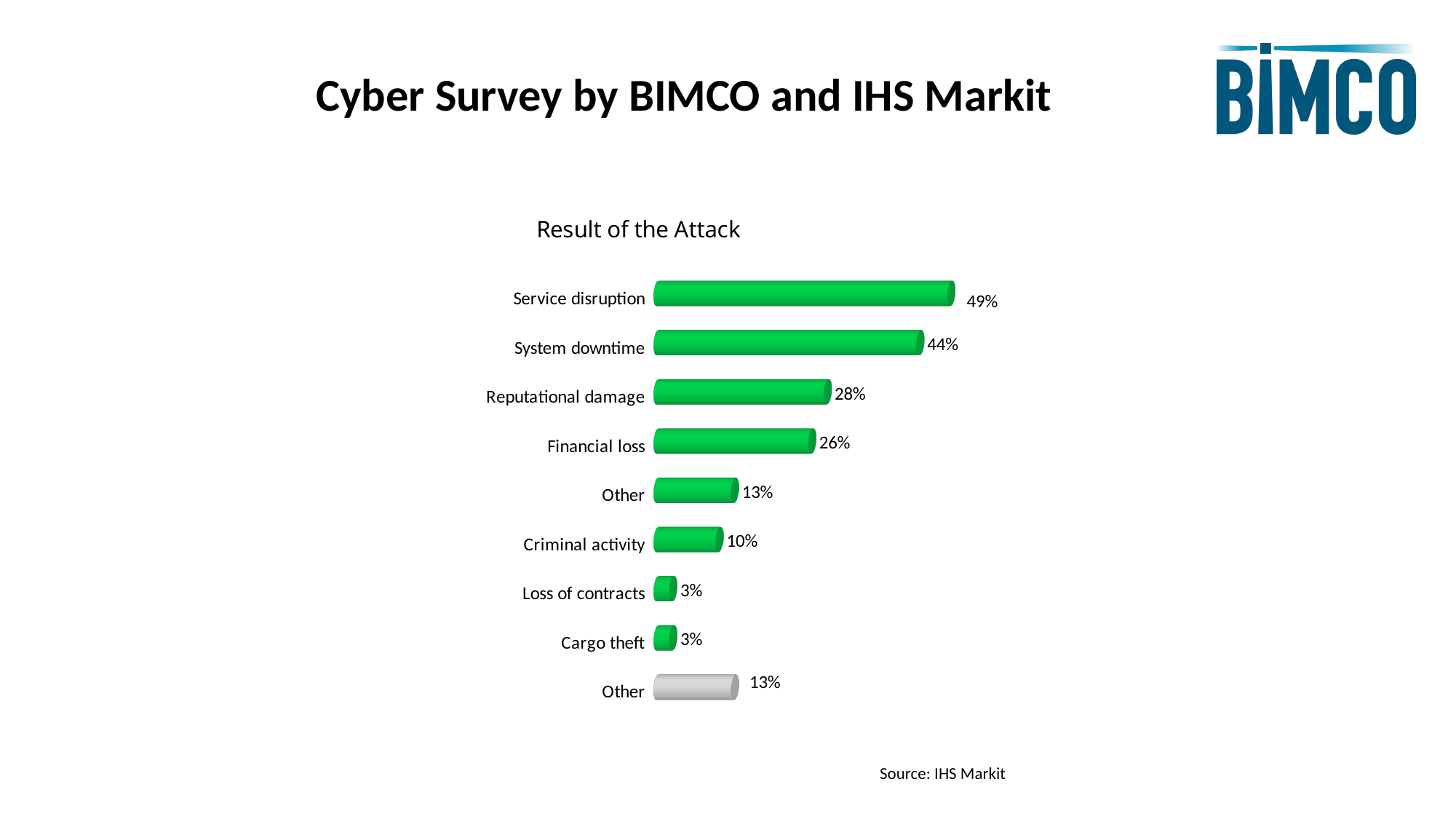
What is the difference between Reputational damage and Financial loss? 2% What is the value for Reputational damage? 28% What is the value for System downtime? 44% What is the value for Service disruption? 49% Which is larger, Financial loss or Criminal activity? Financial loss What is the value for Criminal activity? 10% What is the value for Cargo theft? 3% What is the difference between Service disruption and System downtime? 5% What is the value for Financial loss? 26% Which category has the highest value? Service disruption What is the title of the chart? Result of the Attack What kind of chart is shown on the slide? Bar chart